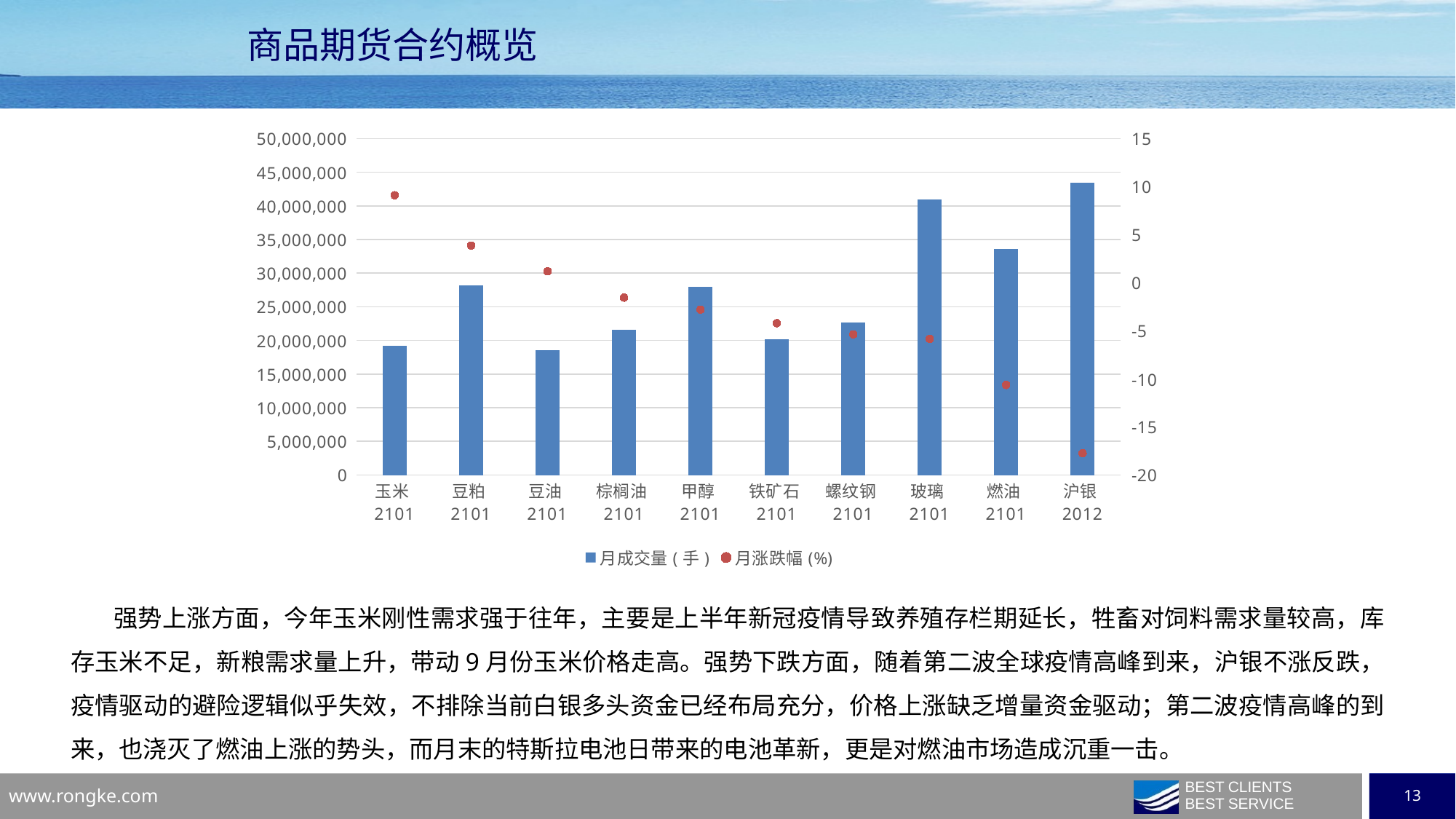
What are the two series named in the chart legend? 月成交量（手） and 月涨跌幅 (%) Which has the larger 月成交量（手） bar, 玻璃 2101 or 燃油 2101? 玻璃 2101 Which contract has the lowest 月涨跌幅 (%) marker? 沪银 2012 What kind of chart is shown on the slide? bar chart combined with dot markers on a secondary axis Is the 月成交量（手） value for 玉米 2101 greater or less than 25,000,000? less Which contract has the highest 月成交量（手） bar? 沪银 2012 Do the 月涨跌幅 (%) markers generally rise or fall from left to right along the x axis? fall How many categories (contracts) are shown on the x axis of the chart? 10 Which contract has the highest 月涨跌幅 (%) marker? 玉米 2101 Is the 月成交量（手） value for 玻璃 2101 greater or less than 35,000,000? greater How many series does the chart legend list? 2 Is the 月涨跌幅 (%) value for 沪银 2012 greater or less than -15? less